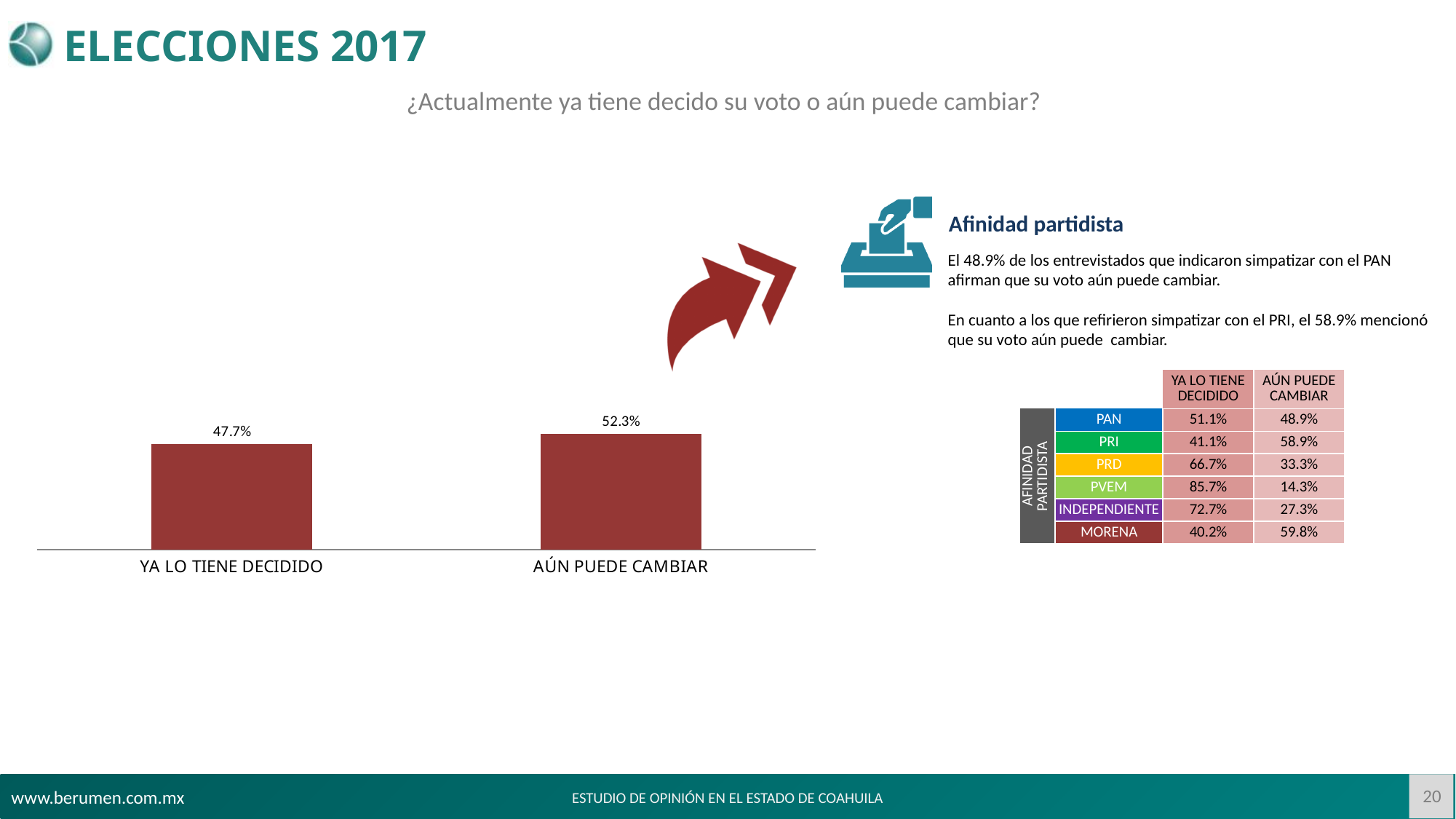
Which category has the highest value in the bar chart? AÚN PUEDE CAMBIAR How many categories are shown in the bar chart? 2 Which category has the lowest value in the bar chart? YA LO TIENE DECIDIDO Which is larger in the bar chart, YA LO TIENE DECIDIDO or AÚN PUEDE CAMBIAR? AÚN PUEDE CAMBIAR What is the value for YA LO TIENE DECIDIDO in the bar chart? 47.7% What question does the bar chart on the slide answer? ¿Actualmente ya tiene decido su voto o aún puede cambiar? What kind of chart is shown on the left of the slide? Bar chart What colour are the bars in the bar chart? Dark red What is the value for AÚN PUEDE CAMBIAR in the bar chart? 52.3% What is the difference between the values for AÚN PUEDE CAMBIAR and YA LO TIENE DECIDIDO in the bar chart? 4.6 percentage points